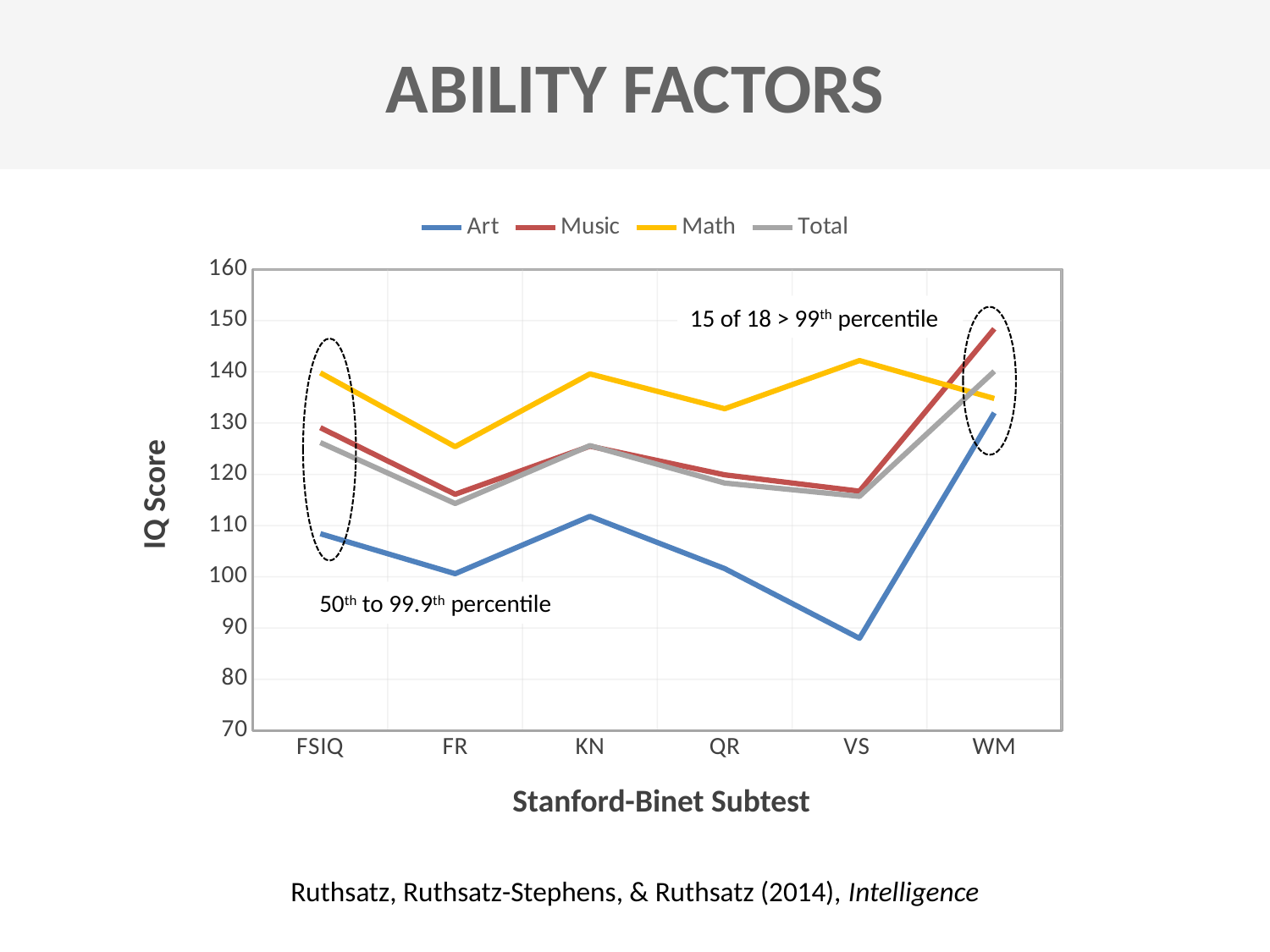
Is the value for Music at WM greater or less than 140? greater At which subtest is the Art series lowest? VS How many subtest categories are shown on the x axis? 6 At which subtest is the Music series highest? WM What kind of chart is shown on the slide? line chart Is the value for Art at VS greater or less than 90? less Does the Art series rise or fall from QR to VS? fall At VS, which series has the larger value, Math or Art? Math Is the value for Total at FR greater or less than 120? less How many series does the legend list? 4 What is the title of the x axis? Stanford-Binet Subtest